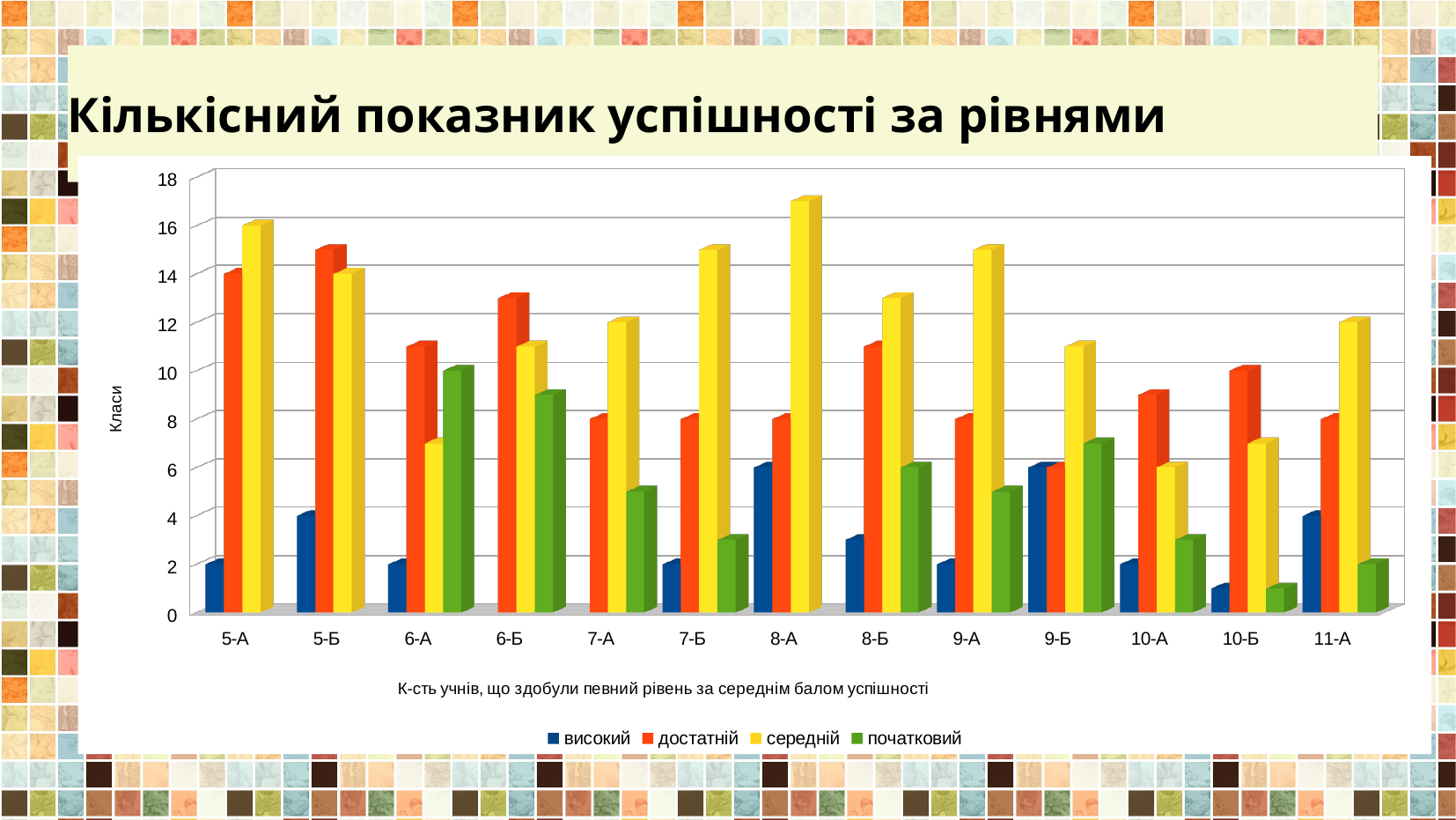
For class 6-А, which is larger: the достатній value or the середній value? достатній For class 10-А, which is larger: the достатній value or the середній value? достатній What kind of chart is shown on the slide? bar chart Which series is shown in yellow in the legend? середній What is the value of the середній series for class 5-А? 16 How many classes (categories) are shown on the x axis? 13 What is the value of the початковий series for class 6-А? 10 Is the value of the середній series for class 8-А greater or less than 16? greater Which class has the highest value for the середній series? 8-А What is the title of the slide's chart? Кількісний показник успішності за рівнями Is the value of the високий series for class 10-Б greater or less than 2? less How many series does the legend list? 4